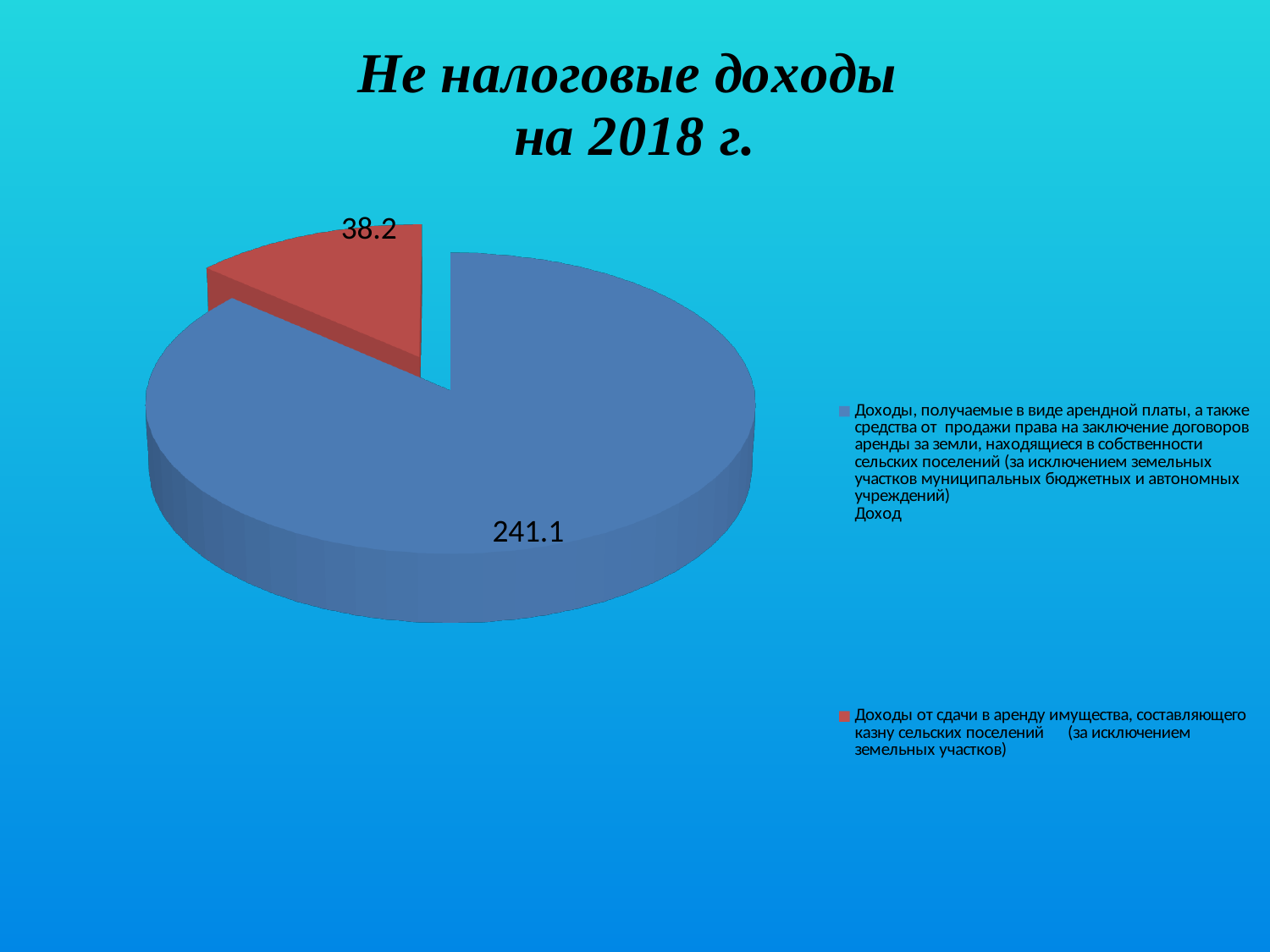
Which is larger: the blue slice or the red slice? the blue slice (241.1) What is the difference between the two slice values, 241.1 and 38.2? 202.9 Which category has the largest slice of the pie? Доходы, получаемые в виде арендной платы, а также средства от продажи права на заключение договоров аренды за земли, находящиеся в собственности сельских поселений What colour is the slice labelled 38.2? red How many entries does the legend list? 2 What is the value of the slice for 'Доходы, получаемые в виде арендной платы, а также средства от продажи права на заключение договоров аренды за земли...'? 241.1 What is the title of the slide containing the chart? Не налоговые доходы на 2018 г. What is the value of the slice for 'Доходы от сдачи в аренду имущества, составляющего казну сельских поселений (за исключением земельных участков)'? 38.2 How many slices does the pie chart have? 2 What is the total of the two slice values shown on the pie chart? 279.3 Which category has the smallest slice of the pie? Доходы от сдачи в аренду имущества, составляющего казну сельских поселений (за исключением земельных участков) What kind of chart is shown on the slide? pie chart